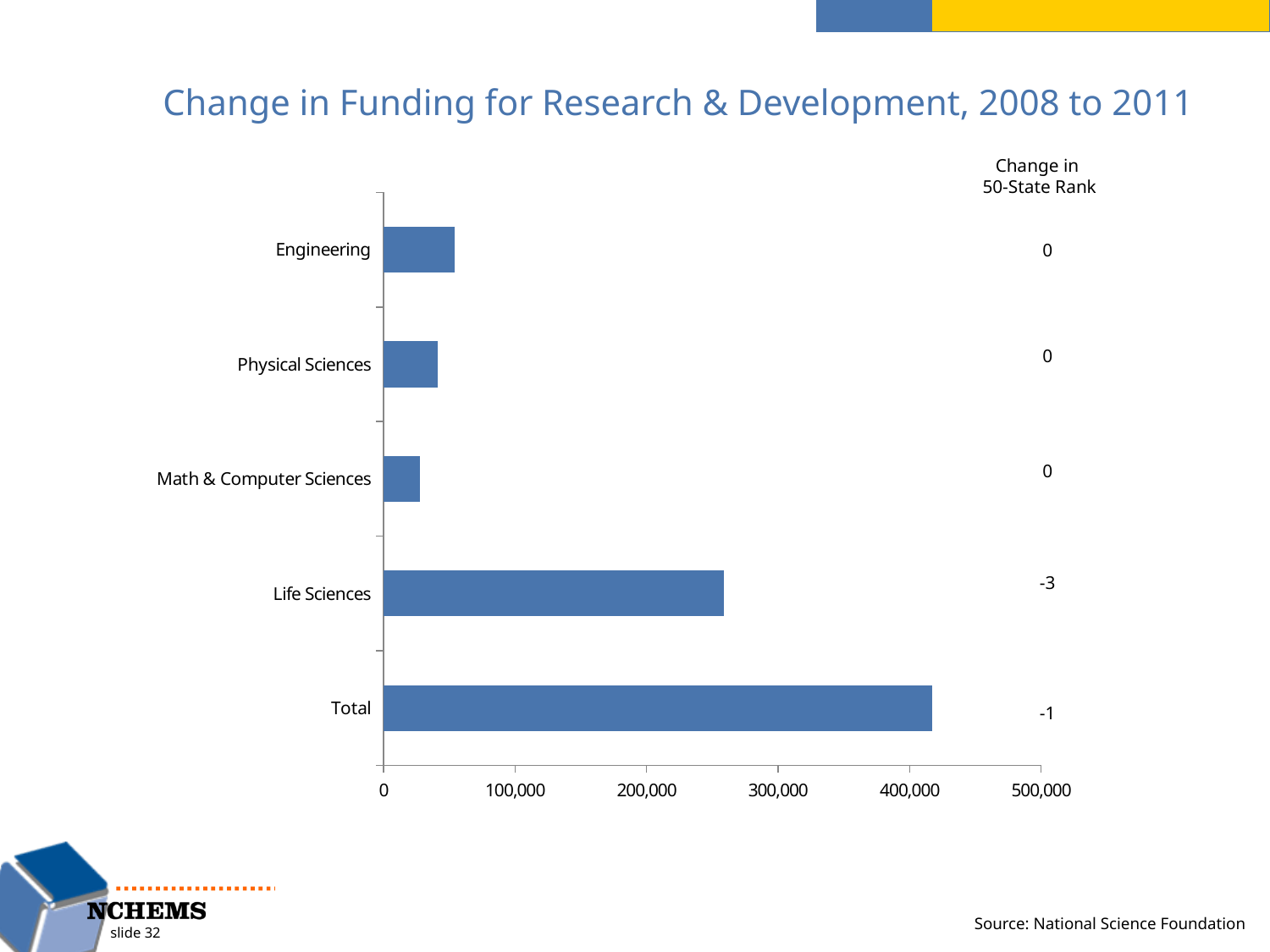
Which is larger, the value for Life Sciences or the value for Math & Computer Sciences? Life Sciences What is the Change in 50-State Rank shown for Life Sciences? -3 Is the value for Engineering greater or less than 100,000? less Which category has the longest bar? Total Is the value for Total greater or less than 400,000? greater Is the value for Life Sciences greater or less than 200,000? greater Which category has the shortest bar? Math & Computer Sciences What kind of chart is shown on the slide? bar chart How many categories are plotted in the chart? 5 What is the title of the chart? Change in Funding for Research & Development, 2008 to 2011 Which is larger, the value for Engineering or the value for Physical Sciences? Engineering